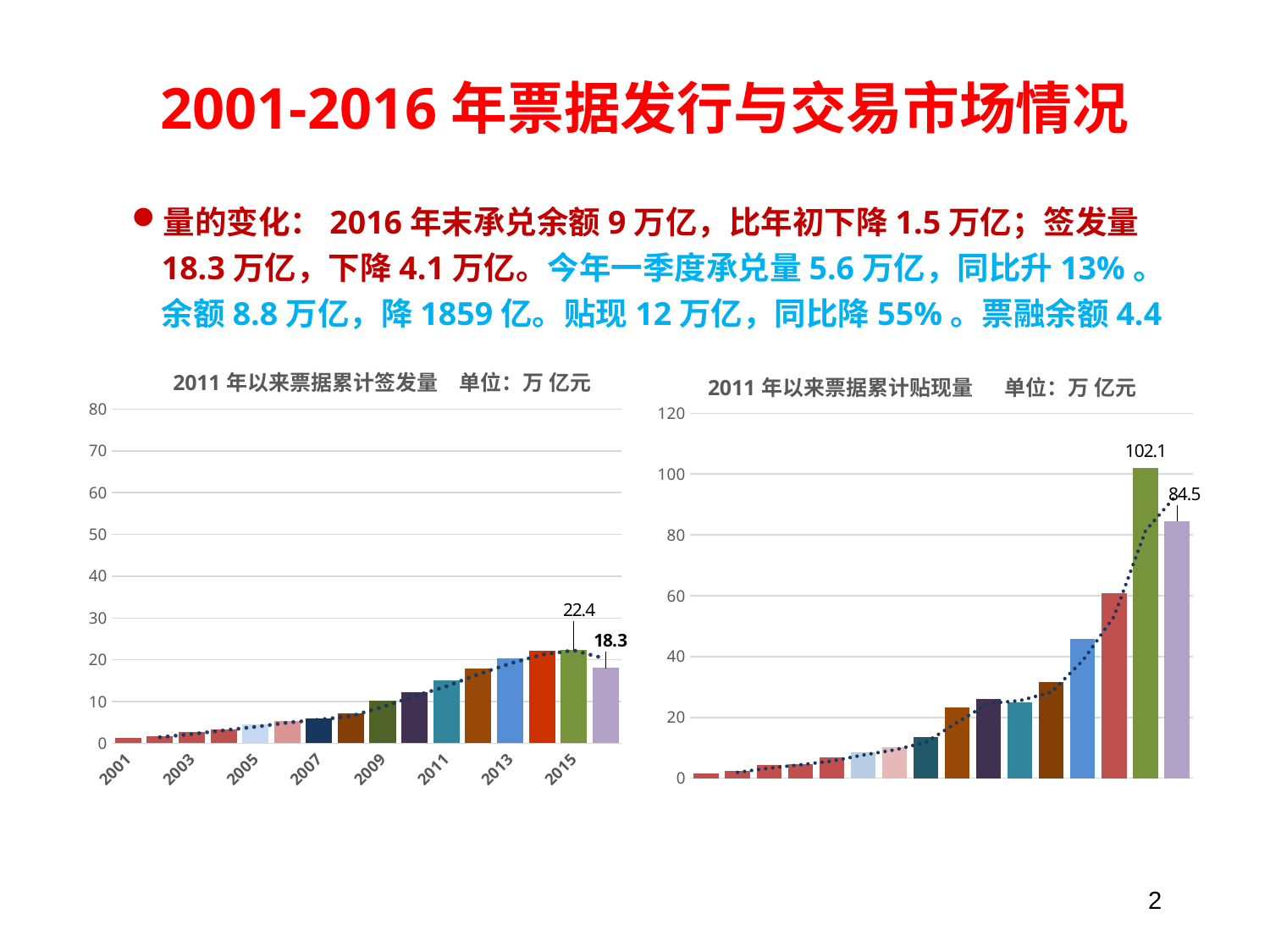
What kind of chart is the left chart titled 2011年以来票据累计签发量? bar chart In the left chart (2011年以来票据累计签发量), is the value for 2009 greater or less than 20? less How many bars are plotted in the left chart (2011年以来票据累计签发量)? 16 In the left chart (2011年以来票据累计签发量), what is the difference between the 2015 value and the rightmost bar's value? 4.1 In the left chart (2011年以来票据累计签发量), what is the value labelled for 2015? 22.4 In the right chart (2011年以来票据累计贴现量), what is the value labelled on the rightmost bar? 84.5 In the left chart (2011年以来票据累计签发量), which year has the tallest bar? 2015 In the left chart (2011年以来票据累计签发量), what is the value labelled on the rightmost bar? 18.3 In the right chart (2011年以来票据累计贴现量), what is the difference between the tallest bar's value and the rightmost bar's value? 17.6 In the left chart (2011年以来票据累计签发量), is the value for 2013 greater or less than 10? greater In the right chart (2011年以来票据累计贴现量), what is the value labelled on the tallest bar? 102.1 In the left chart (2011年以来票据累计签发量), do the values generally rise or fall from 2001 to 2015? rise